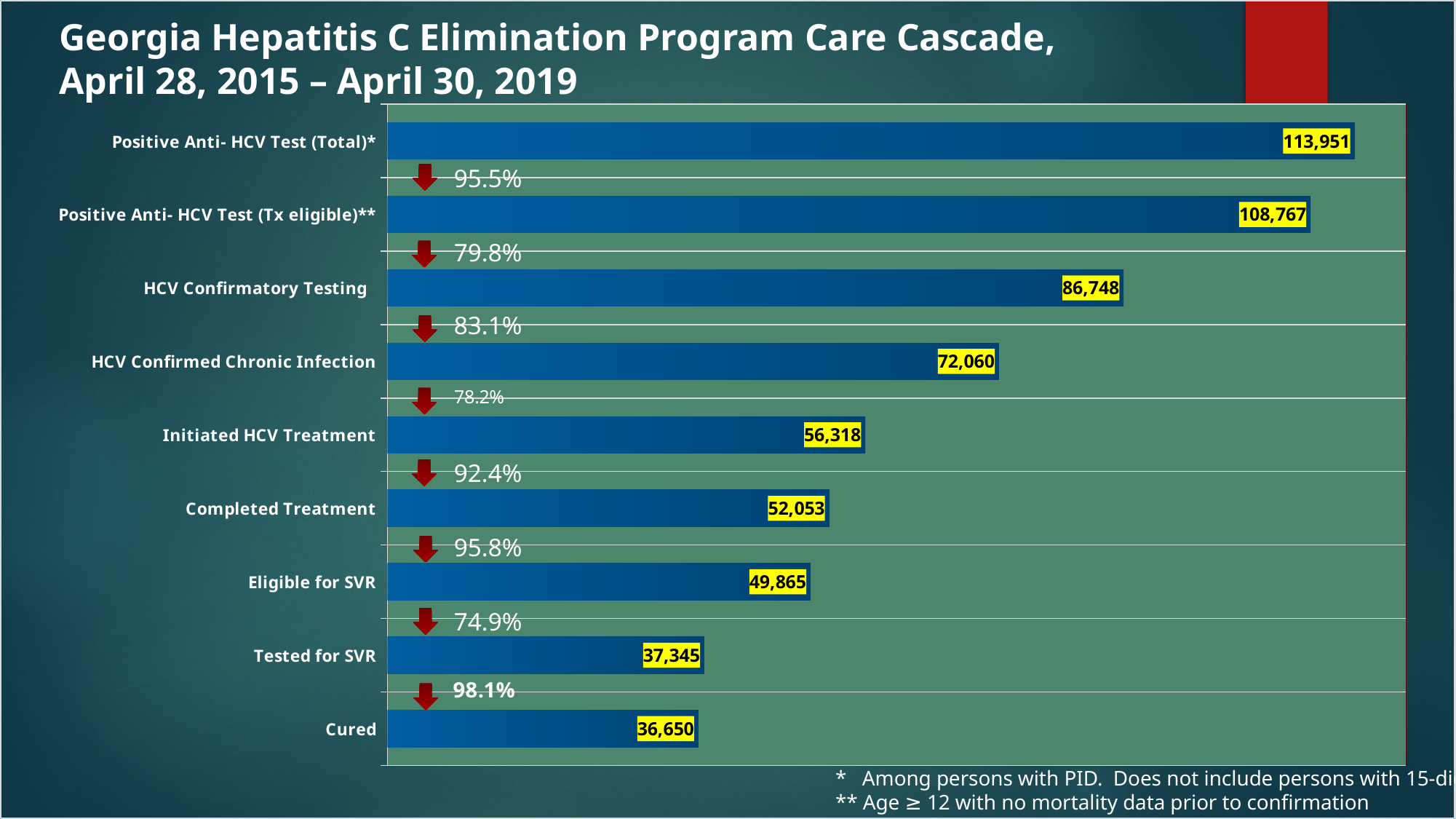
What kind of chart is shown on the slide? Bar chart What is the value for Cured? 36,650 How many categories are shown in the chart? 9 What is the value for Tested for SVR? 37,345 What is the value for HCV Confirmed Chronic Infection? 72,060 What is the difference between Initiated HCV Treatment and Completed Treatment? 4,265 What percentage is shown between Tested for SVR and Cured? 98.1% What is the value for Positive Anti- HCV Test (Total)*? 113,951 What is the difference between Positive Anti- HCV Test (Total)* and Cured? 77,301 Which category has the highest value? Positive Anti- HCV Test (Total)* Which is larger, HCV Confirmatory Testing or Eligible for SVR? HCV Confirmatory Testing Which category has the lowest value? Cured